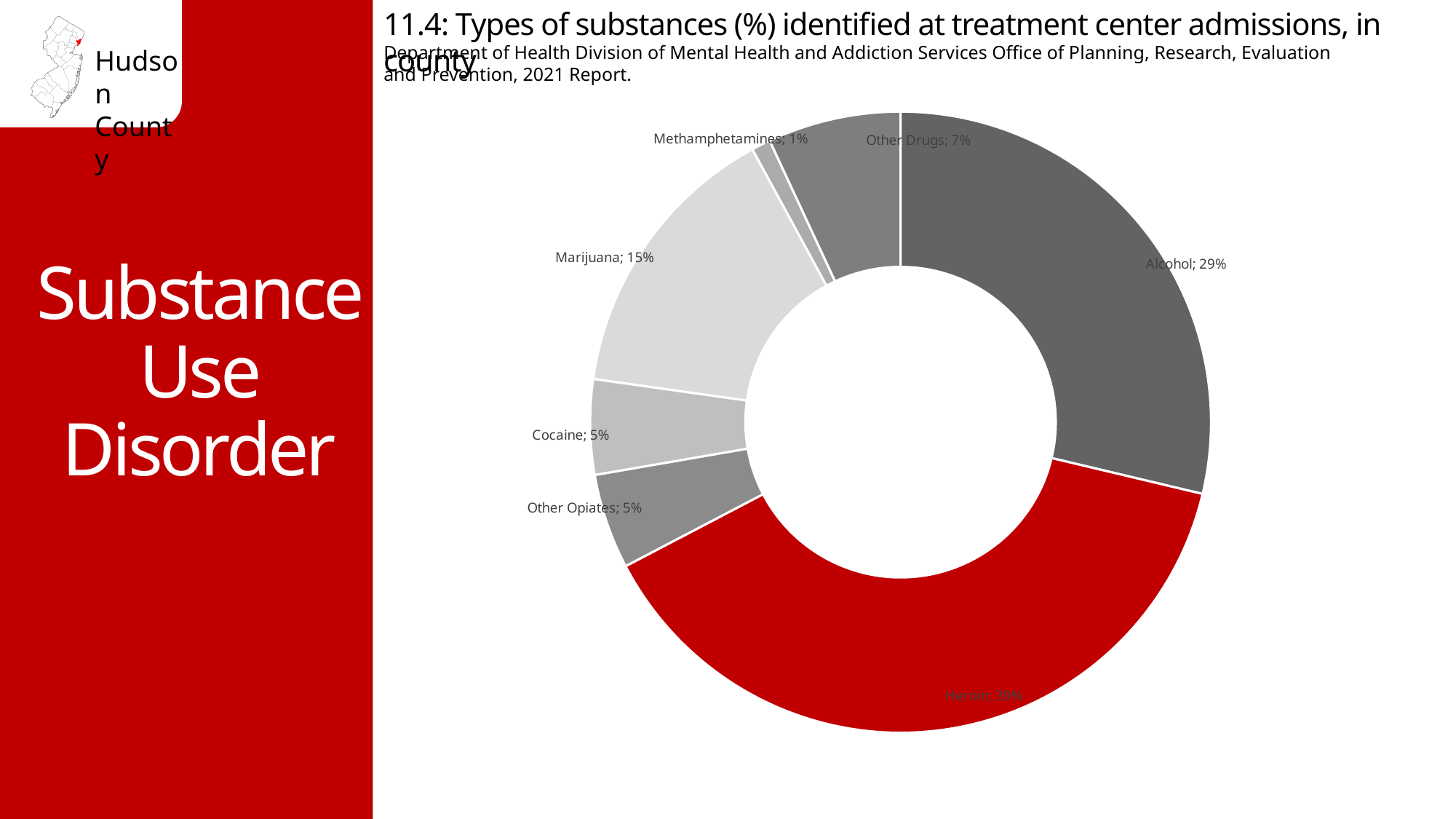
What is the difference in percentage points between Alcohol and Marijuana? 14 What percentage is shown for Methamphetamines? 1% What percentage is shown for Other Drugs? 7% Which substance has the largest slice of the chart? Heroin Which is larger, the share for Alcohol or the share for Other Drugs? Alcohol What percentage is shown for Marijuana? 15% How many substance categories are shown in the chart? 7 Which substance has the smallest slice of the chart? Methamphetamines Which slice of the chart is coloured red? Heroin What kind of chart is shown on the slide? Doughnut chart What percentage of treatment center admissions is attributed to Alcohol? 29% What percentage is shown for Cocaine? 5%